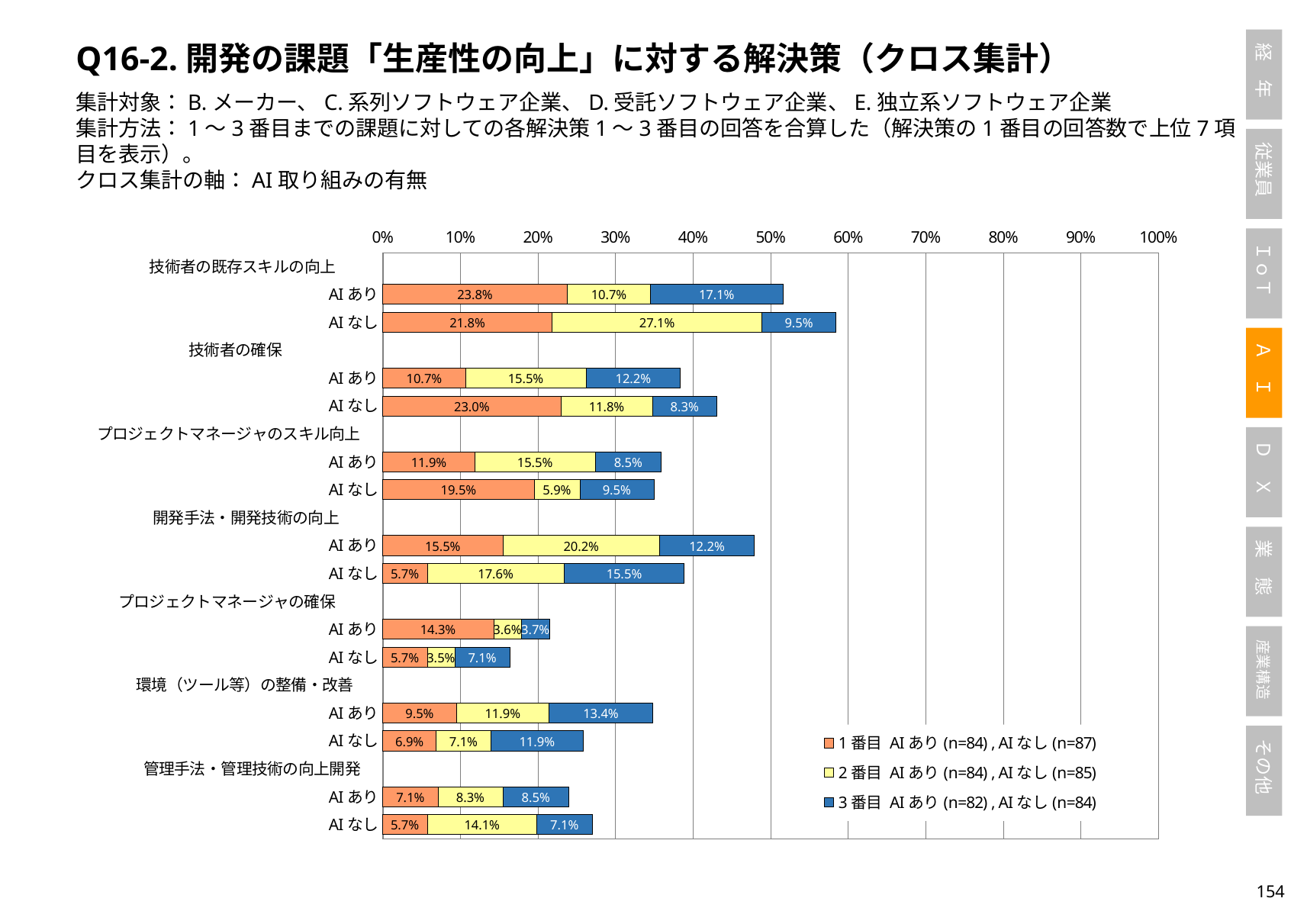
What is the sample size (n) for 1 番目 AI あり shown in the legend? 84 How many solution categories (excluding the AI あり / AI なし sub-rows) are shown on the chart? 7 What is the difference between the 1 番目 values for AI なし and AI あり under 技術者の確保? 12.3% What is the 1 番目 value for AI あり under 技術者の既存スキルの向上? 23.8% What is the 2 番目 value for AI なし under 技術者の既存スキルの向上? 27.1% What is the 3 番目 value for AI あり under 環境（ツール等）の整備・改善? 13.4% How many series does the legend list? 3 Which is larger: the 1 番目 value for AI あり or for AI なし under プロジェクトマネージャの確保? AI あり What is the total of the stacked bar for AI なし under 技術者の既存スキルの向上? 58.4% Is the total of the AI なし bar under 技術者の既存スキルの向上 greater or less than 50%? greater What kind of chart is shown on the slide? Stacked bar chart What is the total of the stacked bar for AI あり under 開発手法・開発技術の向上? 47.9%